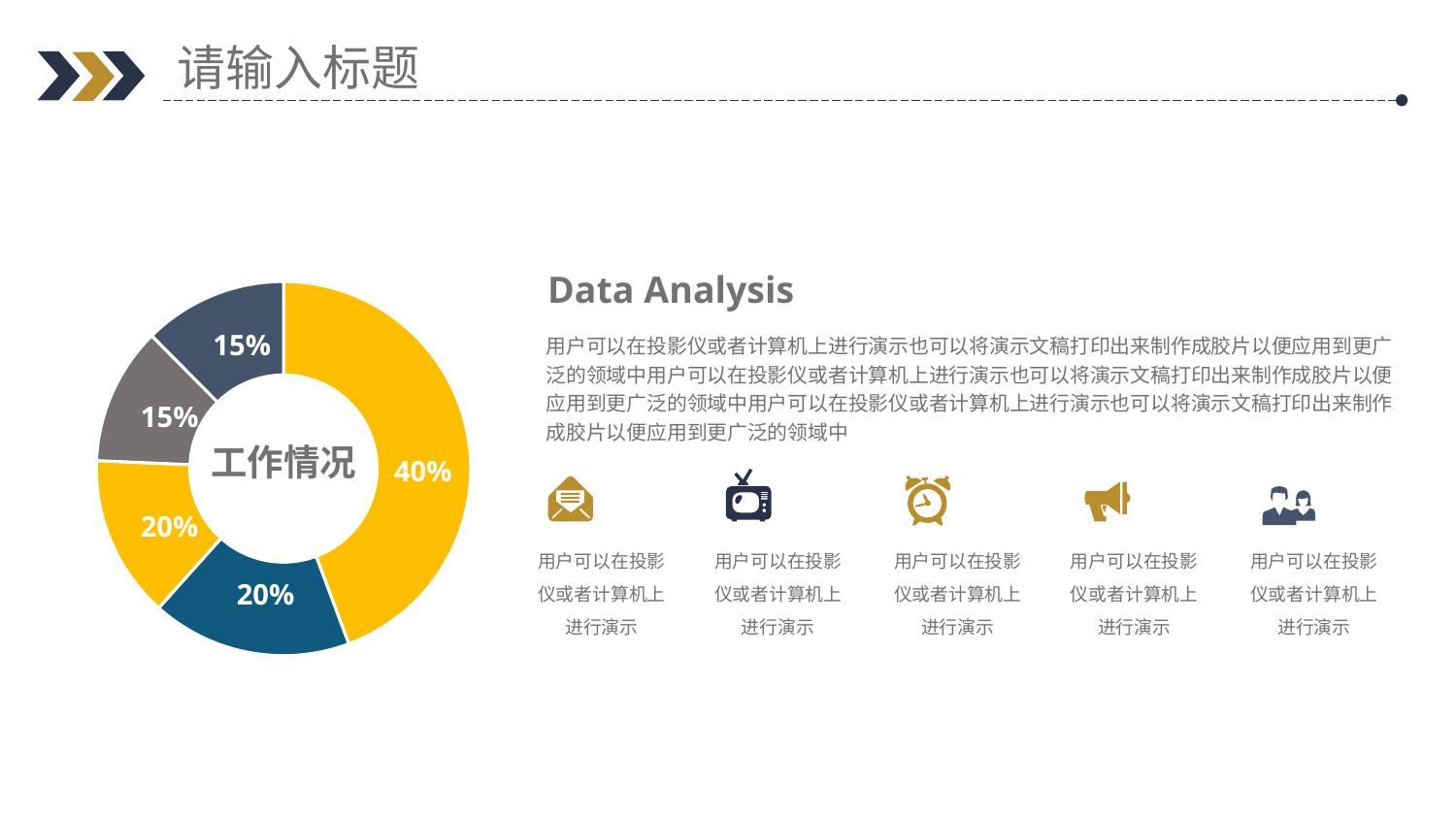
What is the value of the smallest slices in the doughnut chart? 15% What is the combined share of the two 20% slices in the doughnut chart? 40% How many slices does the doughnut chart have? 5 What is the value of the grey slice on the left of the doughnut chart? 15% What is the value of the large yellow slice on the right side of the doughnut chart? 40% What is the difference between the largest slice (40%) and the grey slice (15%)? 25% What kind of chart is shown on the slide? doughnut (pie) chart What is the value of the largest slice in the doughnut chart? 40% Is the value of the dark blue slice at the bottom greater or less than 30%? less What is the value of the dark blue slice at the bottom of the doughnut chart? 20% Which is larger: the yellow slice on the right or the dark blue slice at the bottom? the yellow slice on the right (40%) What text appears in the centre of the doughnut chart? 工作情况